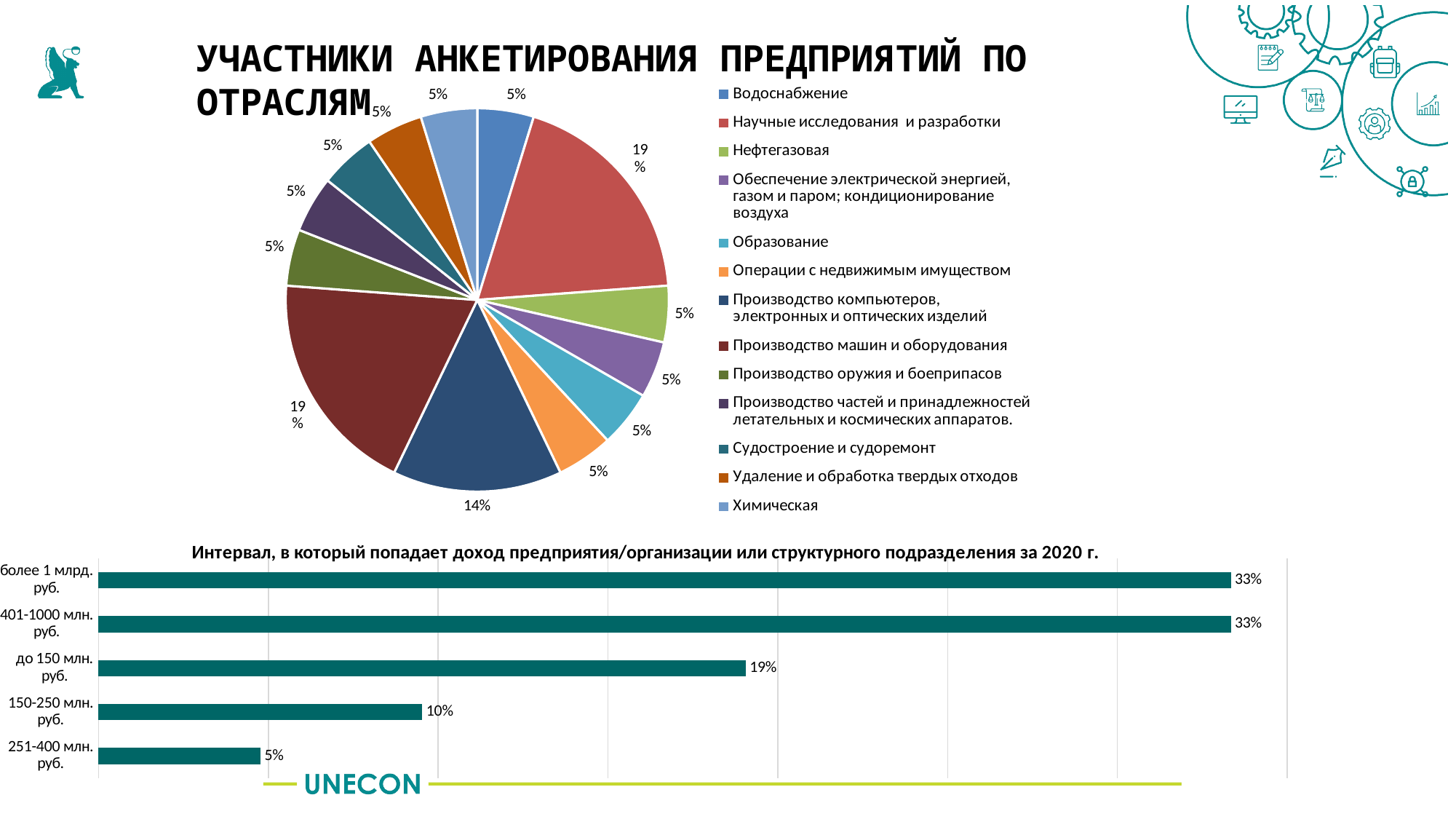
In the bar chart 'Интервал, в который попадает доход предприятия/организации или структурного подразделения за 2020 г.', what is the difference between the value for более 1 млрд. руб. and the value for до 150 млн. руб.? 14% In the pie chart 'Участники анкетирования предприятий по отраслям', how many categories does the legend list? 13 In the pie chart 'Участники анкетирования предприятий по отраслям', what is the difference between the share for Производство машин и оборудования and the share for Производство компьютеров, электронных и оптических изделий? 5% In the bar chart 'Интервал, в который попадает доход предприятия/организации или структурного подразделения за 2020 г.', what is the value for 150-250 млн. руб.? 10% In the bar chart 'Интервал, в который попадает доход предприятия/организации или структурного подразделения за 2020 г.', how many categories are shown? 5 In the bar chart 'Интервал, в который попадает доход предприятия/организации или структурного подразделения за 2020 г.', which category has the lowest value? 251-400 млн. руб. In the bar chart 'Интервал, в который попадает доход предприятия/организации или структурного подразделения за 2020 г.', what is the value for до 150 млн. руб.? 19% In the pie chart 'Участники анкетирования предприятий по отраслям', which is larger: the share for Производство машин и оборудования or the share for Образование? Производство машин и оборудования In the pie chart 'Участники анкетирования предприятий по отраслям', what share is labelled for Научные исследования и разработки? 19% In the pie chart 'Участники анкетирования предприятий по отраслям', what share is labelled for Производство компьютеров, электронных и оптических изделий? 14% In the pie chart 'Участники анкетирования предприятий по отраслям', what share is labelled for Химическая? 5% What kind of chart is the chart titled 'Интервал, в который попадает доход предприятия/организации или структурного подразделения за 2020 г.'? bar chart